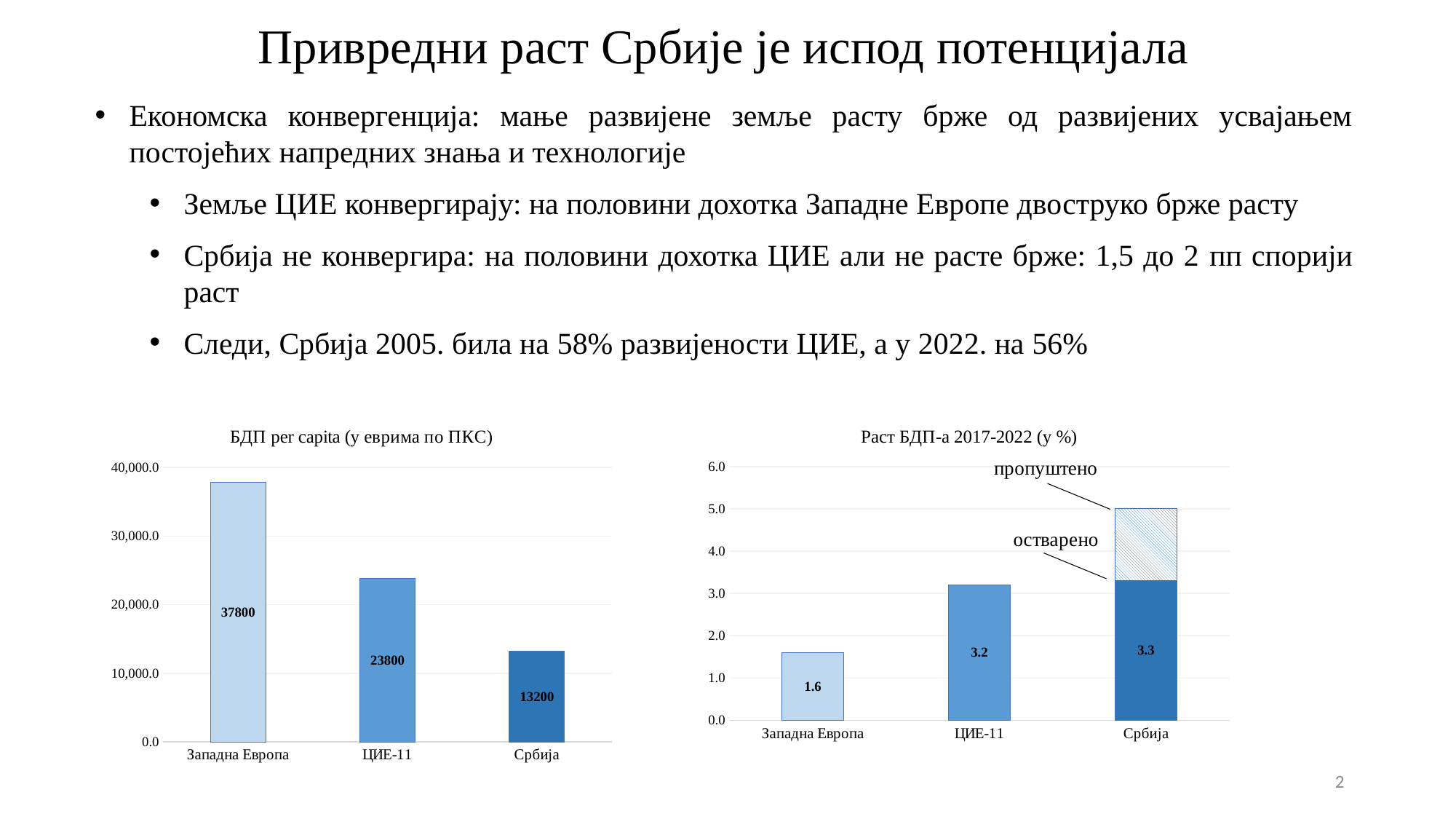
In the chart titled 'Раст БДП-а 2017-2022 (у %)', what label is given to the hatched portion of the Србија bar? пропуштено In the chart titled 'БДП per capita (у еврима по ПКС)', do the values rise or fall from left to right? fall In the chart titled 'Раст БДП-а 2017-2022 (у %)', what is the labelled value for ЦИЕ-11? 3.2 In the chart titled 'Раст БДП-а 2017-2022 (у %)', what is the labelled value for Западна Европа? 1.6 In the chart titled 'Раст БДП-а 2017-2022 (у %)', what is the difference between the labelled values for ЦИЕ-11 and Западна Европа? 1.6 In the chart titled 'БДП per capita (у еврима по ПКС)', what is the value for Западна Европа? 37800 In the chart titled 'БДП per capita (у еврима по ПКС)', what is the difference between the values for Западна Европа and ЦИЕ-11? 14000 In the chart titled 'Раст БДП-а 2017-2022 (у %)', is the top of the Србија bar including the hatched 'пропуштено' portion greater or less than 4.0? greater In the chart titled 'БДП per capita (у еврима по ПКС)', what is the value for Србија? 13200 What kind of chart is the chart titled 'Раст БДП-а 2017-2022 (у %)'? bar chart In the chart titled 'БДП per capita (у еврима по ПКС)', how many categories are shown? 3 In the chart titled 'БДП per capita (у еврима по ПКС)', which category has the lowest value? Србија